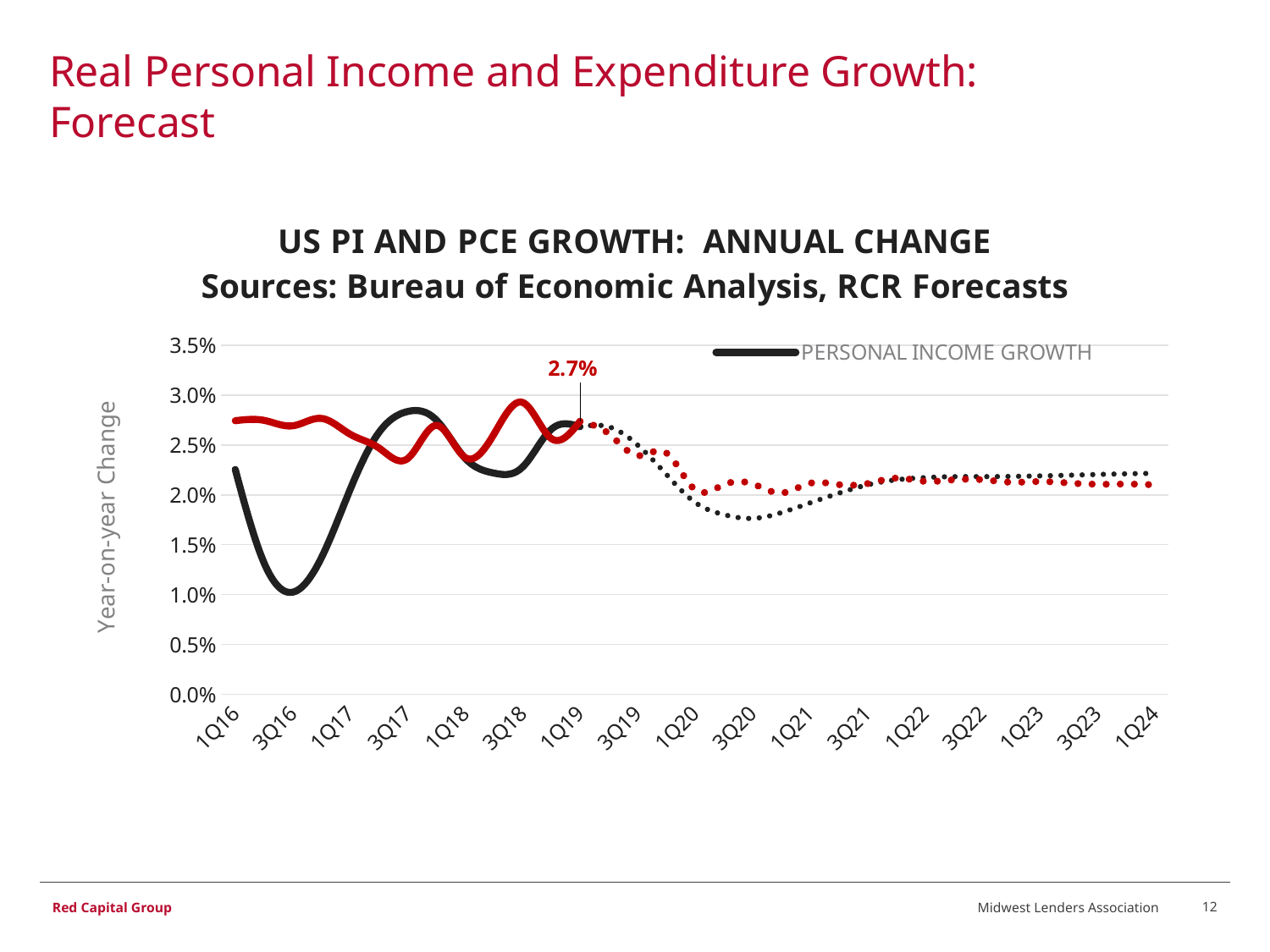
At which quarter does the Personal Income Growth line reach its lowest point? 3Q16 Is the Personal Income Growth value at 1Q24 greater or less than 2.0%? greater What is the title of the vertical axis? Year-on-year Change How many quarter labels are shown on the x axis? 17 Does the Personal Income Growth line rise or fall between 1Q16 and 3Q16? fall What value is printed as a data label on the red line at 1Q19? 2.7% What kind of chart is shown on the slide? line chart What series name is shown in the chart legend? PERSONAL INCOME GROWTH Is the Personal Income Growth value at 3Q16 greater or less than 1.5%? less Is the Personal Income Growth value at 3Q20 greater or less than 2.0%? less At 3Q16, is the Personal Income Growth line above or below the red line? below